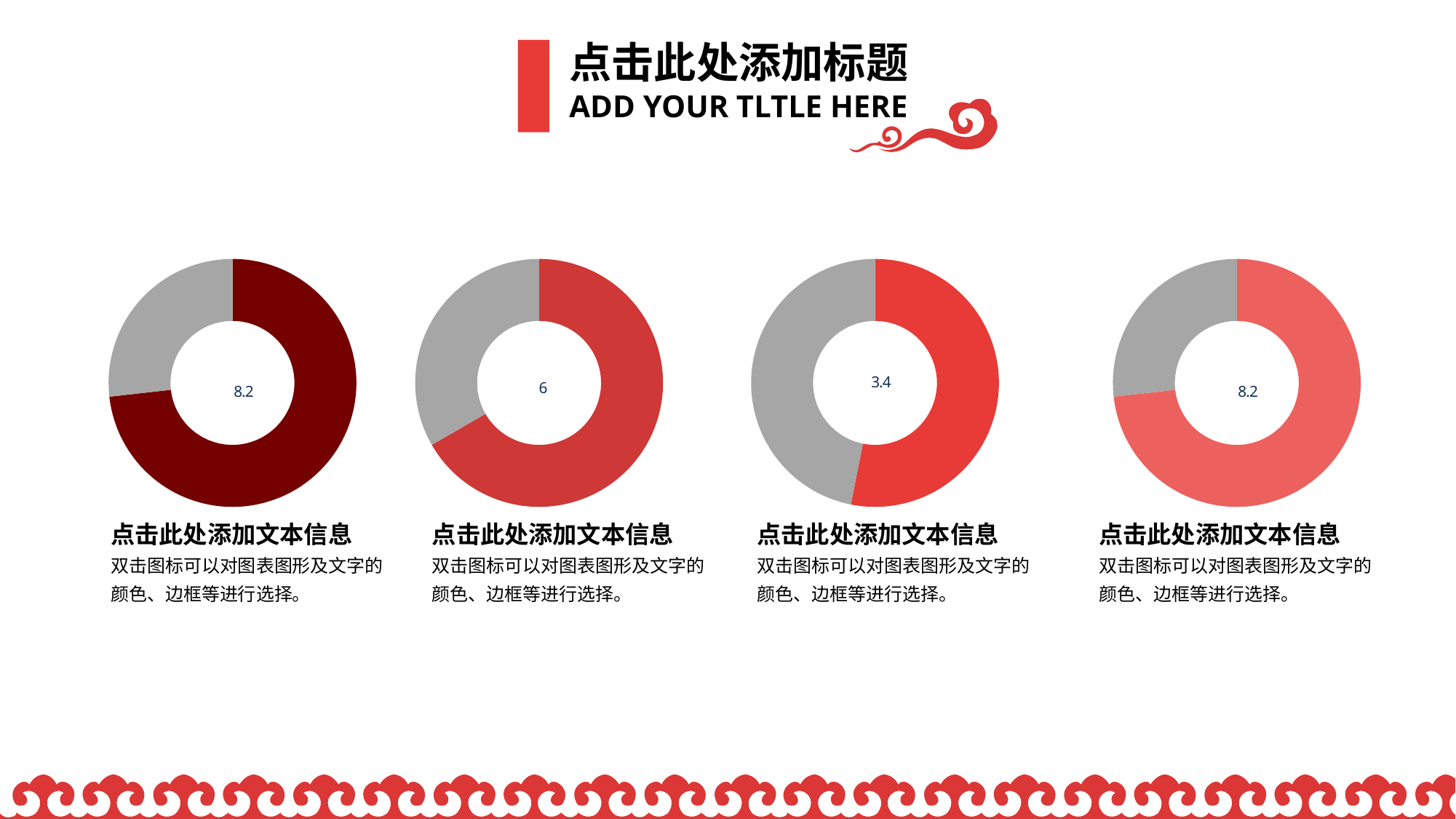
How many segments does each donut chart contain? 2 What colour is the non-highlighted segment in each donut chart? grey What value is printed in the centre of the rightmost donut chart? 8.2 Which donut chart has the lowest centre value? the third chart from the left (3.4) What value is printed in the centre of the leftmost donut chart? 8.2 How many donut charts are shown on the slide? 4 What value is printed in the centre of the second donut chart from the left? 6 Which centre value is larger, the second donut chart's or the third donut chart's? the second chart (6) What kind of chart is used for each of the four figures on the slide? donut (pie) chart What is the difference between the centre values of the second and third donut charts? 2.6 What value is printed in the centre of the third donut chart from the left? 3.4 What is the difference between the centre values of the leftmost and third donut charts? 4.8